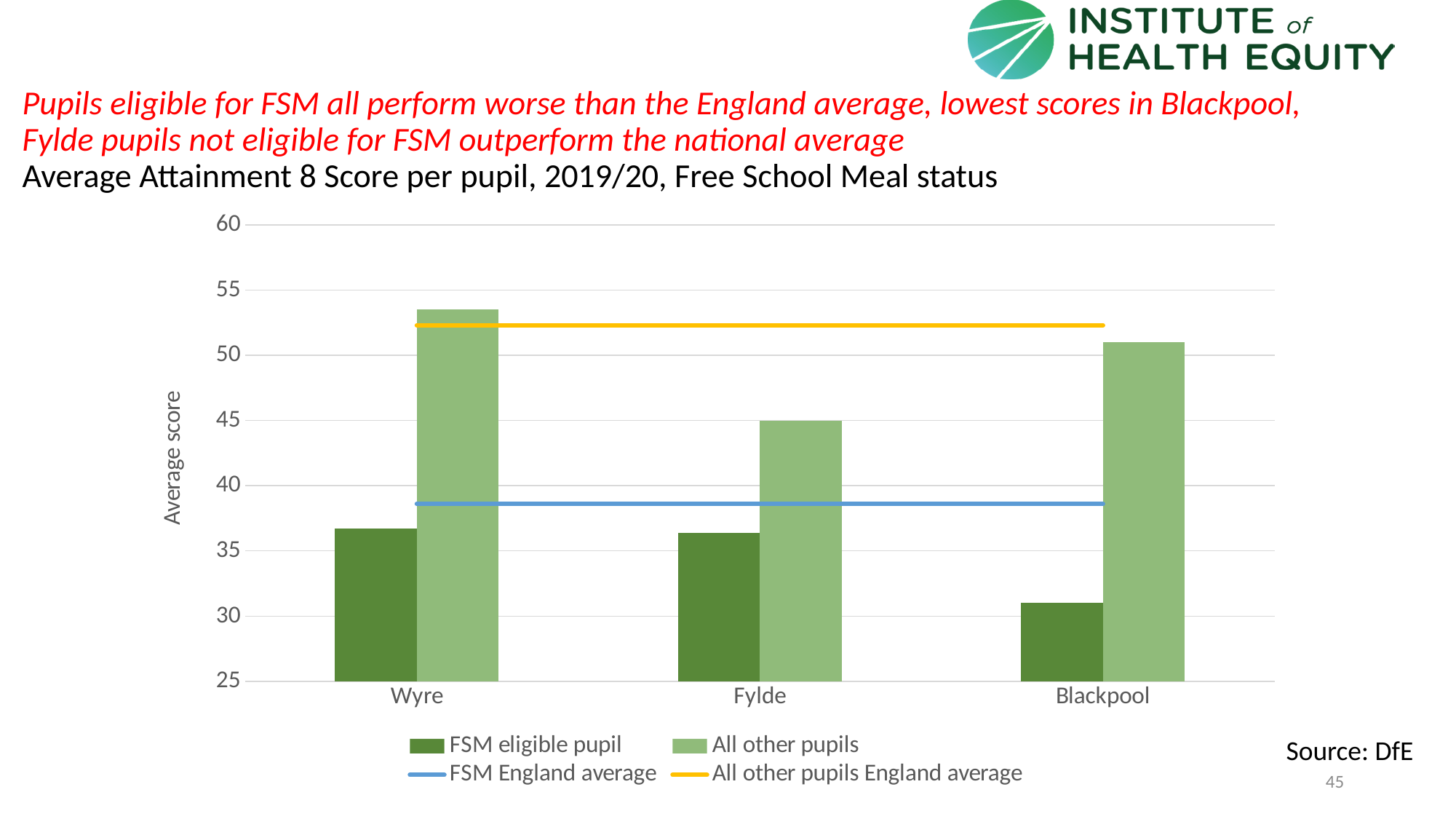
Which area has the lowest score for FSM eligible pupils? Blackpool How many series does the legend list? 4 How many areas (categories) are shown on the x axis? 3 What kind of chart is shown on the slide? Combination bar and line chart What colour is the line representing the All other pupils England average? Yellow What is the title of the chart? Average Attainment 8 Score per pupil, 2019/20, Free School Meal status Is the FSM eligible pupil score for Blackpool greater or less than 35? less Which is larger: the All other pupils score for Fylde or for Blackpool? Blackpool Is the All other pupils score for Wyre greater or less than 50? greater Which area has the highest score for All other pupils? Wyre Is the FSM eligible pupil score for Wyre greater or less than 40? less Which area has the lowest score for All other pupils? Fylde